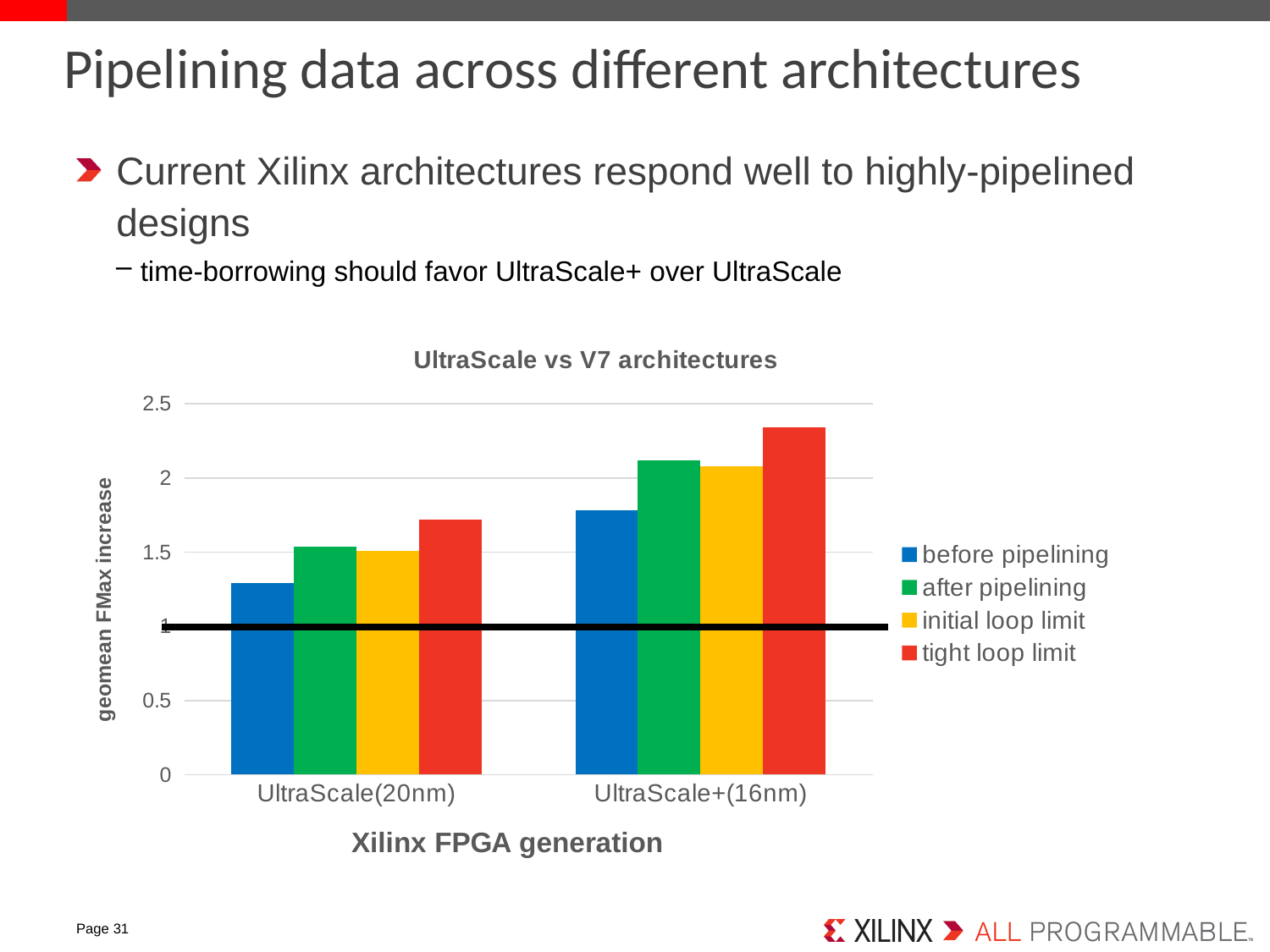
How many categories are shown on the x axis of the chart? 2 What is the label of the y axis of the chart? geomean FMax increase Is the value for 'before pipelining' at UltraScale+(16nm) greater or less than 2? less Which series has the highest value for UltraScale+(16nm)? tight loop limit How many series does the chart legend list? 4 What is the title of the chart? UltraScale vs V7 architectures What type of chart is shown on the slide? bar chart Which is larger: the 'tight loop limit' value for UltraScale(20nm) or for UltraScale+(16nm)? UltraScale+(16nm) Is the value for 'tight loop limit' at UltraScale(20nm) greater or less than 1.5? greater Is the value for 'before pipelining' at UltraScale(20nm) greater or less than 1.5? less Which series has the lowest value for UltraScale(20nm)? before pipelining